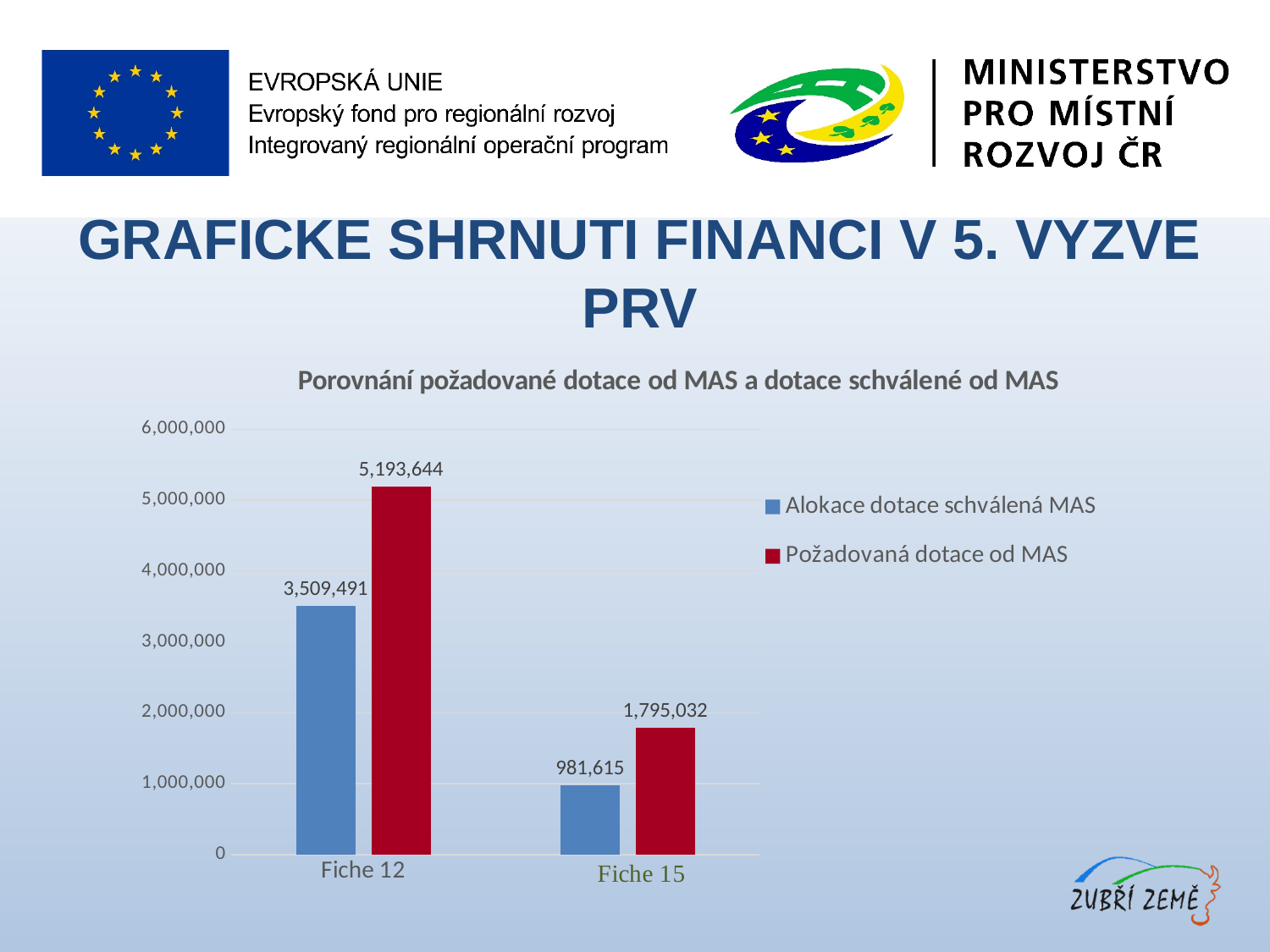
Which category has the highest value for Požadovaná dotace od MAS? Fiche 12 What is the difference between Požadovaná dotace od MAS and Alokace dotace schválená MAS for Fiche 15? 813,417 What kind of chart is shown on the slide? Bar chart What is the value of Alokace dotace schválená MAS for Fiche 12? 3,509,491 What is the value of Požadovaná dotace od MAS for Fiche 15? 1,795,032 Which category has the lowest value for Alokace dotace schválená MAS? Fiche 15 How many categories are shown on the x axis of the chart? 2 How many series does the chart legend list? 2 What is the value of Požadovaná dotace od MAS for Fiche 12? 5,193,644 For Fiche 15, which is larger: Alokace dotace schválená MAS or Požadovaná dotace od MAS? Požadovaná dotace od MAS What is the difference between Požadovaná dotace od MAS and Alokace dotace schválená MAS for Fiche 12? 1,684,153 What is the value of Alokace dotace schválená MAS for Fiche 15? 981,615